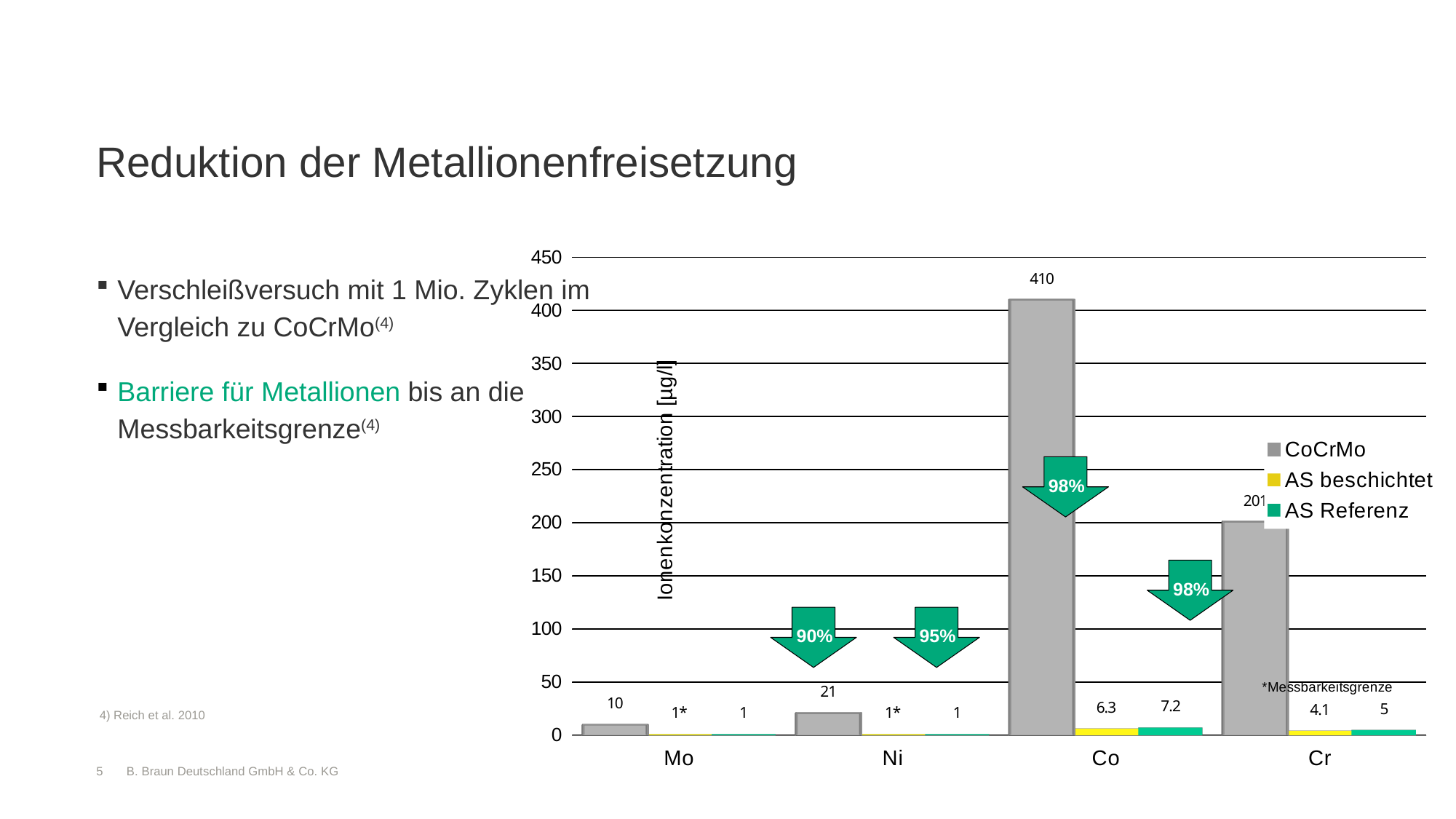
What is the AS Referenz value for Co? 7.2 What is the CoCrMo value for Ni? 21 How many series does the legend list? 3 What type of chart is shown on the slide? bar chart What percentage reduction is shown by the arrow above the Co bars? 98% What is the difference between the CoCrMo value for Ni and the CoCrMo value for Mo? 11 How many element categories are shown on the x axis? 4 Which element has the lowest CoCrMo value? Mo Which element has the highest CoCrMo value? Co Is the CoCrMo value for Cr greater or less than 150? greater What is the AS beschichtet value for Cr? 4.1 What is the CoCrMo value for Co? 410